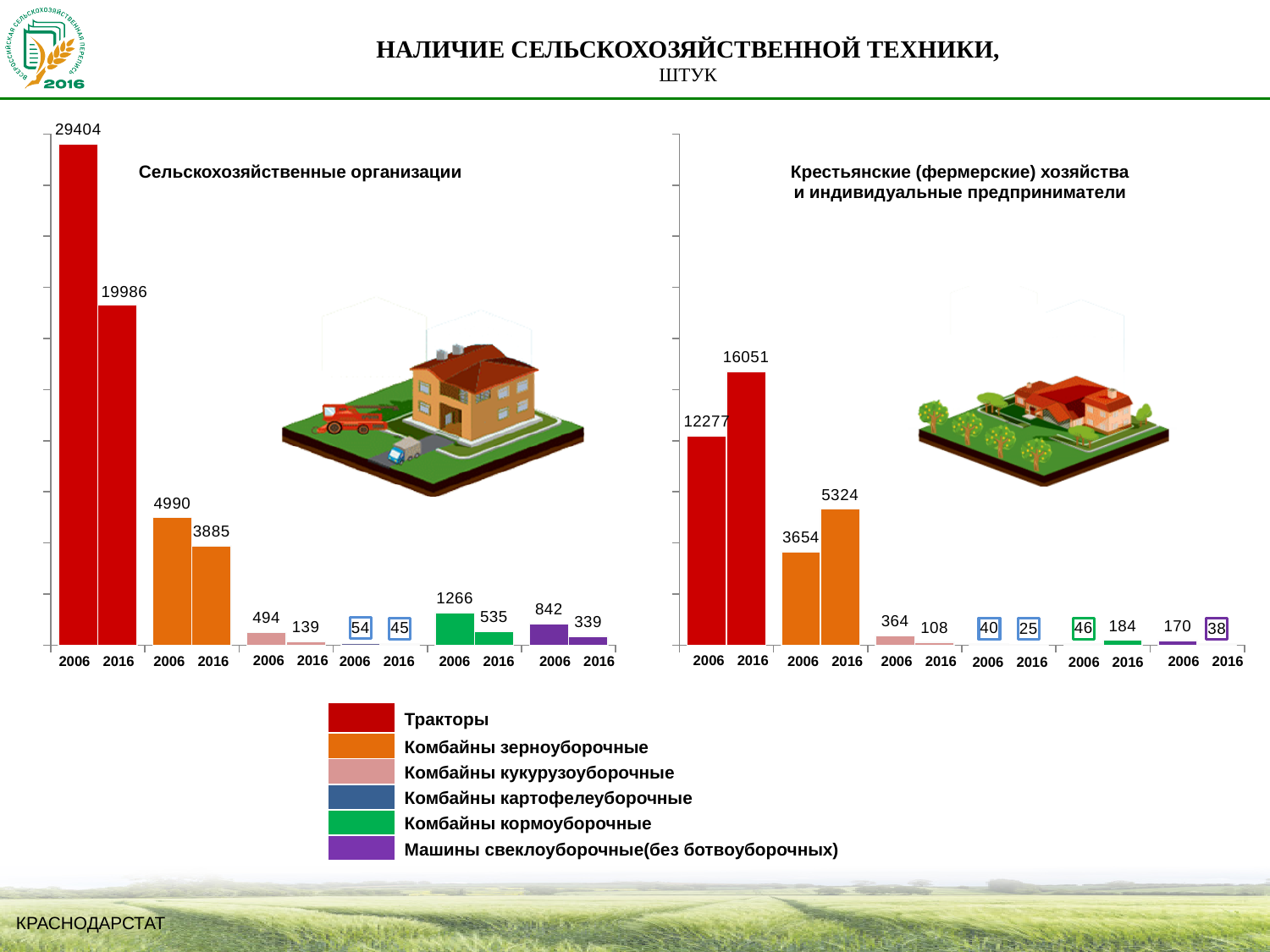
In the chart titled "Крестьянские (фермерские) хозяйства и индивидуальные предприниматели", what is the value for Комбайны кормоуборочные in 2016? 184 In the chart titled "Сельскохозяйственные организации", do the values for Комбайны кормоуборочные rise or fall from 2006 to 2016? fall What kind of chart is used on this slide? bar chart How many series does the legend list? 6 In the chart titled "Крестьянские (фермерские) хозяйства и индивидуальные предприниматели", what is the value for Тракторы in 2016? 16051 In the chart titled "Сельскохозяйственные организации", what is the value for Тракторы in 2006? 29404 In the chart titled "Сельскохозяйственные организации", which bar is the highest? Тракторы 2006 In the chart titled "Сельскохозяйственные организации", by how much did the number of Тракторы decrease from 2006 to 2016? 9418 In the chart titled "Крестьянские (фермерские) хозяйства и индивидуальные предприниматели", which is larger: Тракторы in 2006 or Тракторы in 2016? 2016 In the chart titled "Крестьянские (фермерские) хозяйства и индивидуальные предприниматели", which bar is the lowest? Комбайны картофелеуборочные 2016 In the chart titled "Крестьянские (фермерские) хозяйства и индивидуальные предприниматели", what is the difference between Комбайны зерноуборочные in 2016 and 2006? 1670 In the chart titled "Сельскохозяйственные организации", what is the value for Комбайны зерноуборочные in 2016? 3885